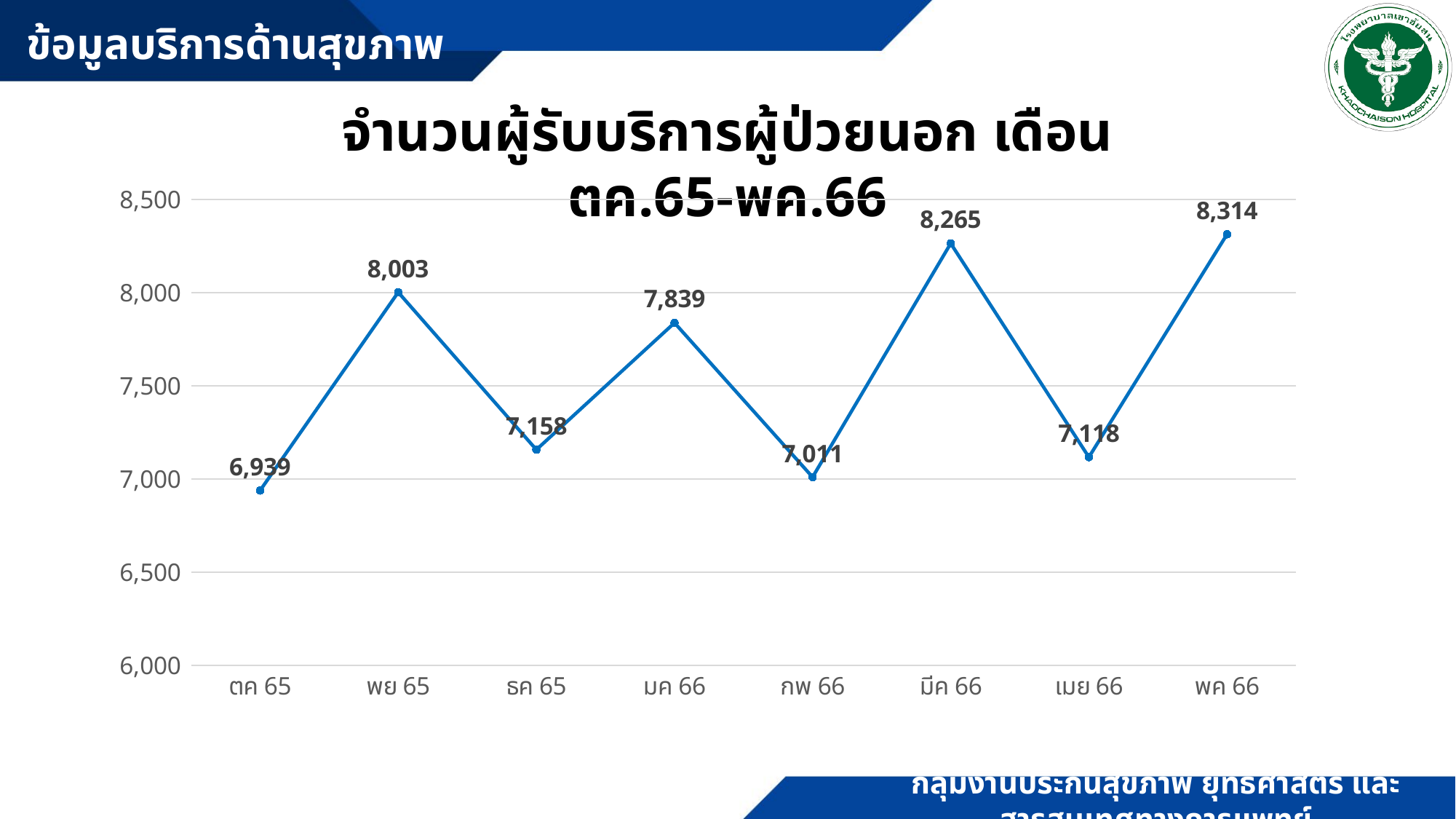
Which is larger, the value for มค 66 or the value for เมย 66? มค 66 What is the value for ตค 65? 6,939 Does the value rise or fall from เมย 66 to พค 66? rise Which month has the lowest value? ตค 65 Is the value for ธค 65 greater or less than 7,500? less What is the difference between the values for พย 65 and ธค 65? 845 What is the value for มีค 66? 8,265 What is the difference between the values for พค 66 and มีค 66? 49 How many months are plotted on the chart? 8 Which month has the highest value? พค 66 What type of chart is shown on the slide? Line chart What is the value for กพ 66? 7,011